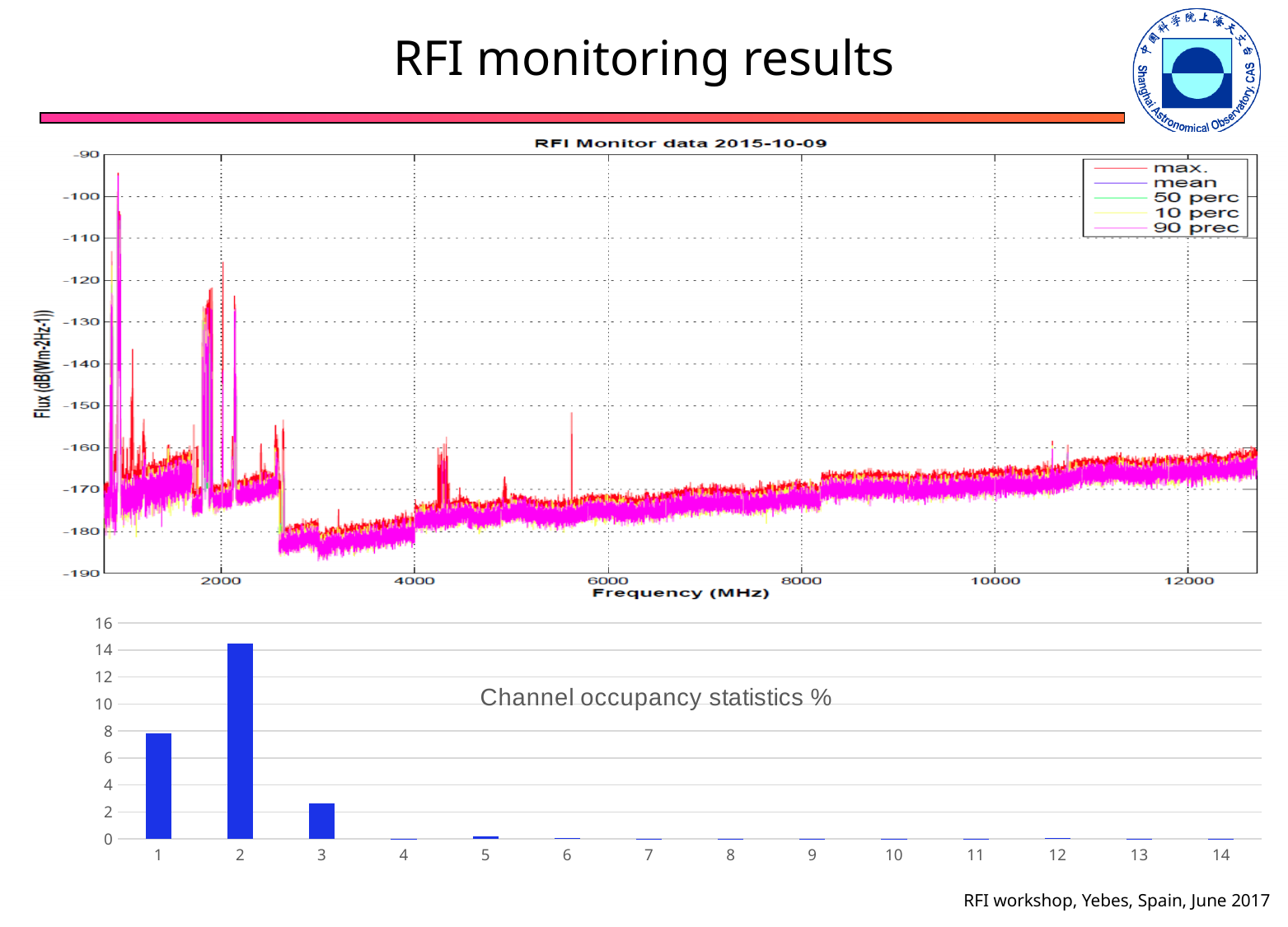
What is the title of the top chart on the slide? RFI Monitor data 2015-10-09 What kind of chart is the bottom chart titled "Channel occupancy statistics %"? bar chart In the bottom chart "Channel occupancy statistics %", is the value for category 2 greater or less than 14? greater In the bottom chart "Channel occupancy statistics %", is the value for category 3 greater or less than 2? greater How many series does the legend of the top chart "RFI Monitor data 2015-10-09" list? 5 In the bottom chart "Channel occupancy statistics %", which category has the highest bar? 2 In the bottom chart "Channel occupancy statistics %", how many categories are shown on the x axis? 14 In the bottom chart "Channel occupancy statistics %", what is the highest value shown on the y axis? 16 In the bottom chart "Channel occupancy statistics %", which is larger, the value for category 1 or the value for category 3? category 1 What kind of chart is the top chart "RFI Monitor data 2015-10-09"? line chart What is the x-axis label of the top chart "RFI Monitor data 2015-10-09"? Frequency (MHz)